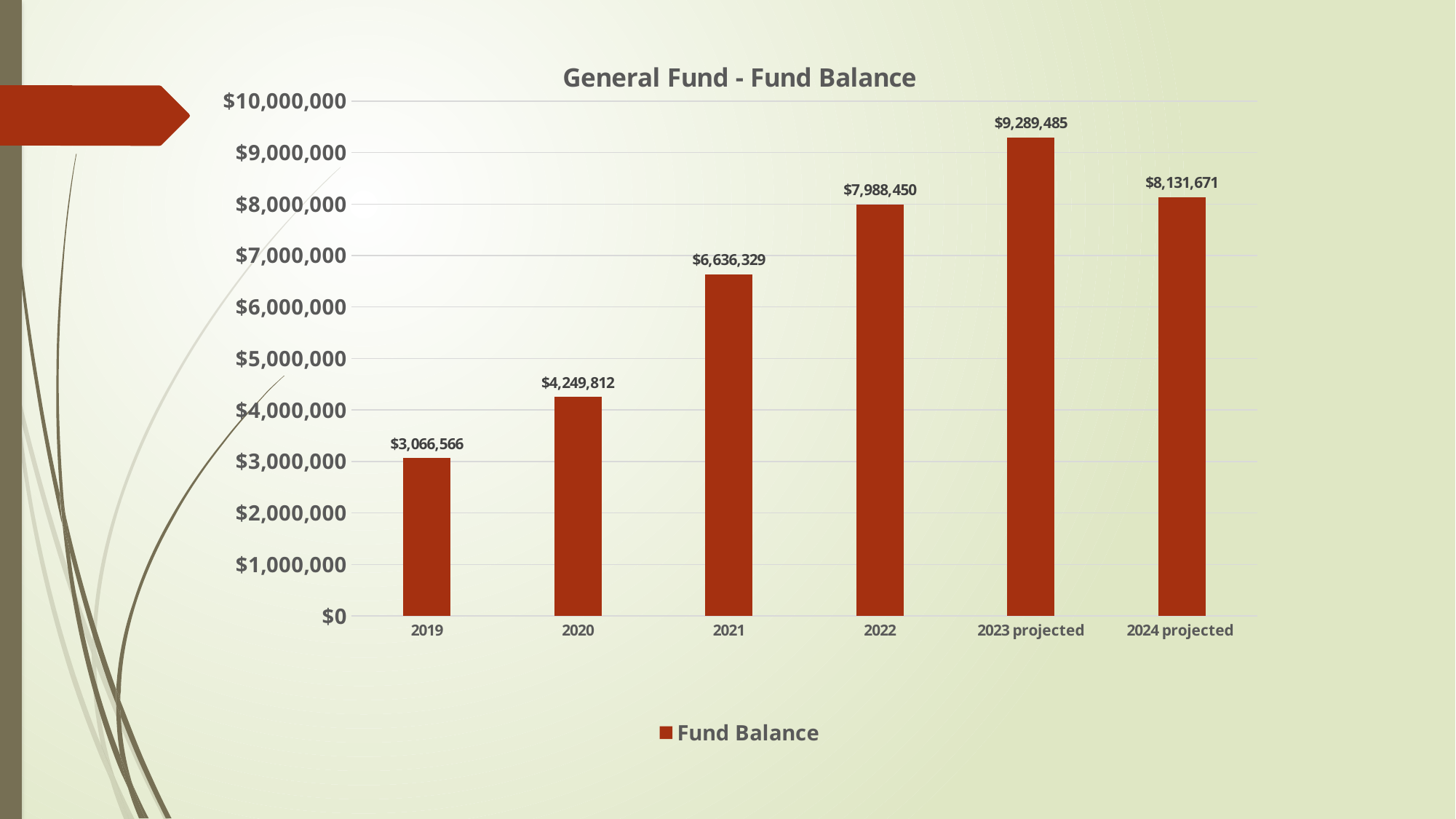
What is the difference between the 2020 and 2019 fund balances? $1,183,246 What is the fund balance shown for 2024 projected? $8,131,671 Is the fund balance for 2022 greater or less than $8,000,000? less Which is larger, the fund balance for 2022 or for 2024 projected? 2024 projected Which year has the highest fund balance? 2023 projected How many years are shown on the x axis? 6 What type of chart is shown on the slide? bar chart How much larger is the 2023 projected fund balance than the 2024 projected fund balance? $1,157,814 Which year has the lowest fund balance? 2019 What is the title of the chart? General Fund - Fund Balance What is the fund balance for 2021? $6,636,329 What is the fund balance for 2019? $3,066,566